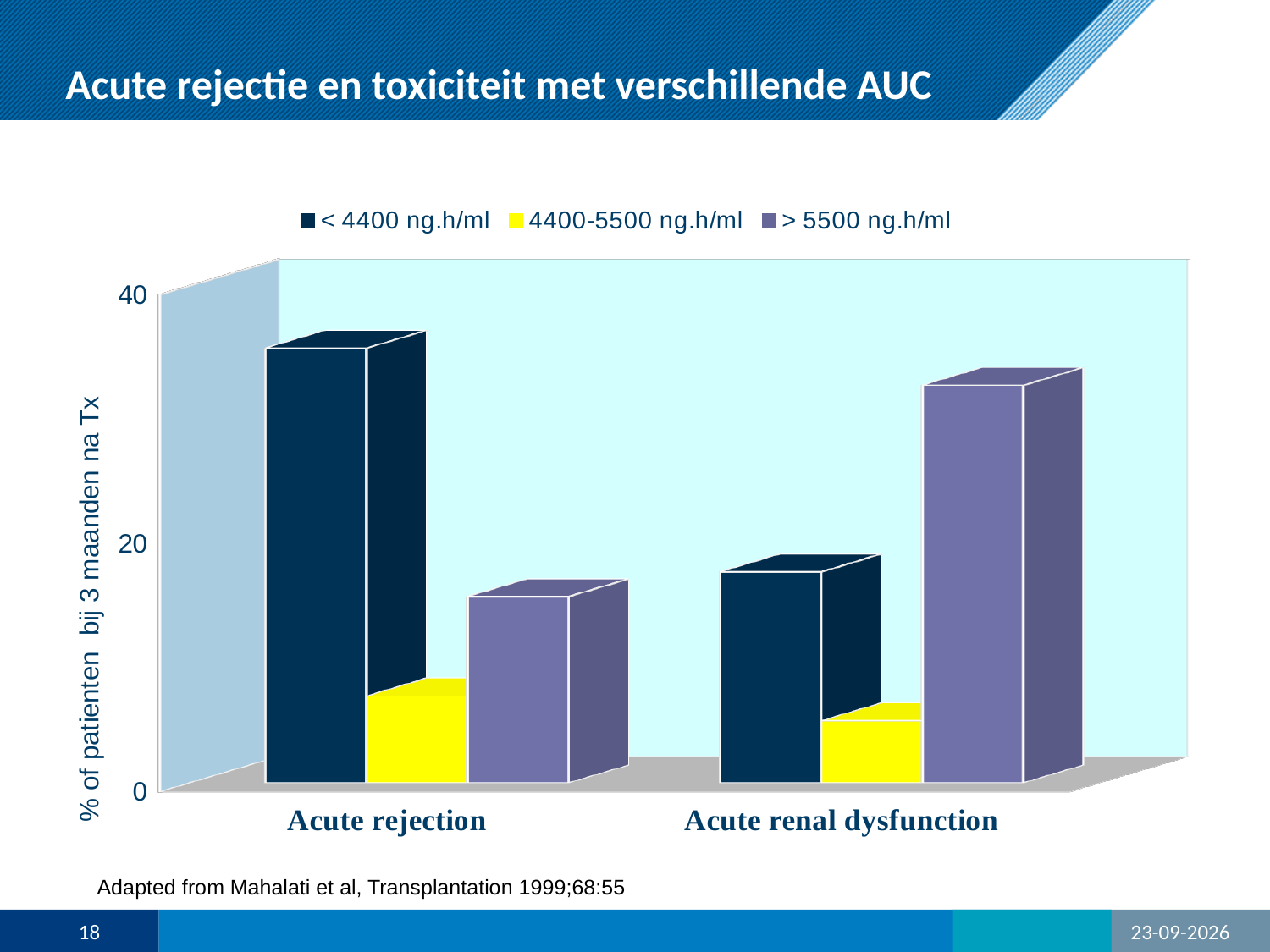
How many categories are shown on the x axis? 2 What kind of chart is shown on the slide? bar chart Is the value for > 5500 ng.h/ml in the Acute renal dysfunction category greater or less than 20? greater Which AUC group has the lowest value in the Acute renal dysfunction category? 4400-5500 ng.h/ml Which AUC group has the highest value in the Acute rejection category? < 4400 ng.h/ml Is the value for < 4400 ng.h/ml in the Acute rejection category greater or less than 20? greater How many series does the legend list? 3 For the < 4400 ng.h/ml series, which category has the larger value: Acute rejection or Acute renal dysfunction? Acute rejection Which AUC group has the highest value in the Acute renal dysfunction category? > 5500 ng.h/ml Is the value for 4400-5500 ng.h/ml in the Acute renal dysfunction category greater or less than 20? less What is the label of the y axis? % of patienten bij 3 maanden na Tx